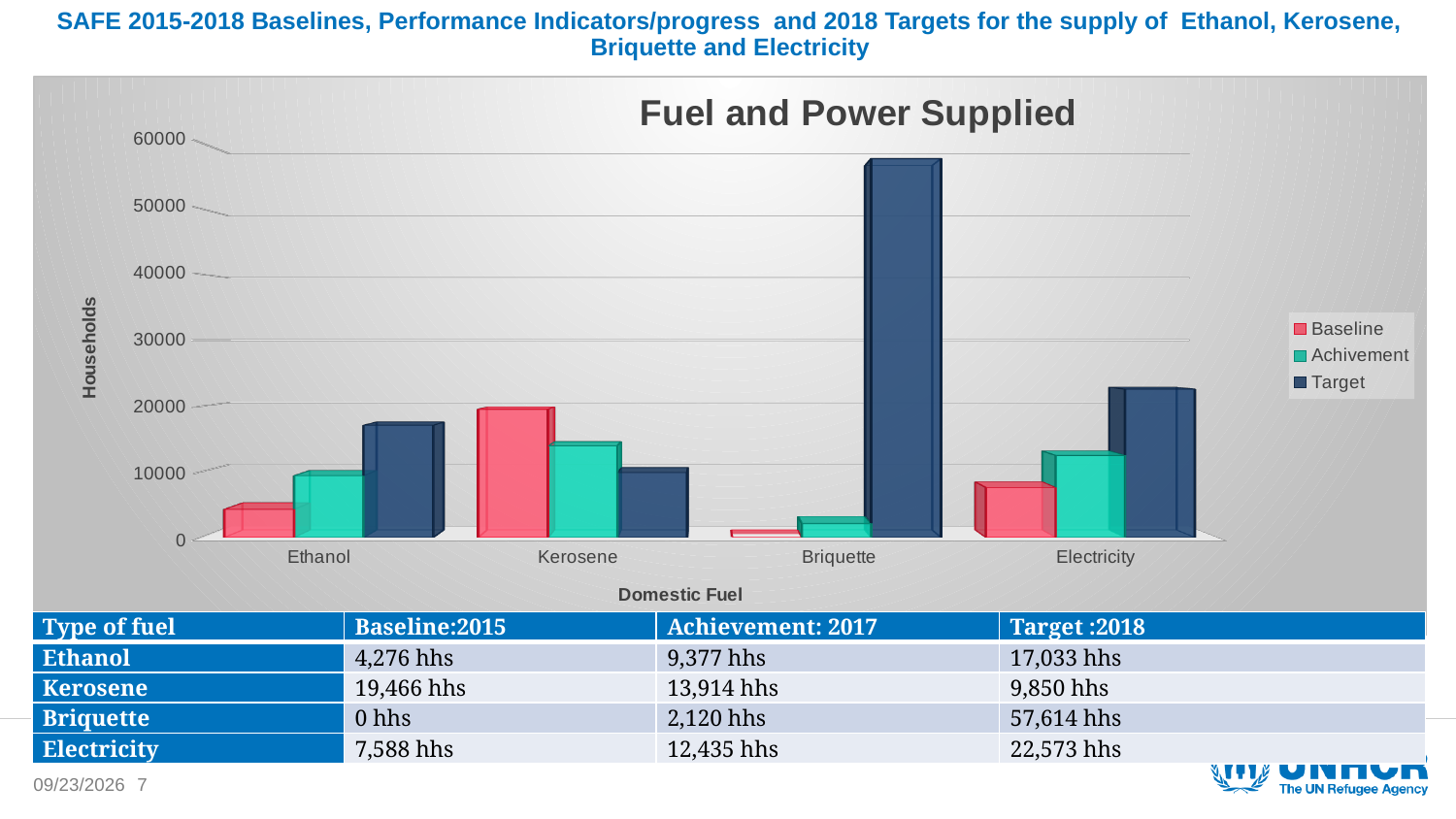
What is the Achievement value for Electricity? 12,435 hhs What is the Baseline value for Kerosene? 19,466 hhs What kind of chart is shown on the slide? bar chart What is the difference between the Target and Baseline values for Ethanol? 12,757 hhs What is the label on the vertical axis of the chart? Households How many fuel categories are shown on the x axis of the chart? 4 Which fuel has the highest Target value? Briquette Which fuel has the lowest Baseline value? Briquette Which is larger for Kerosene, the Baseline or the Target? Baseline What is the Target value for Briquette? 57,614 hhs How many series does the legend of the Fuel and Power Supplied chart list? 3 Is the Target value for Briquette greater or less than 50000? greater